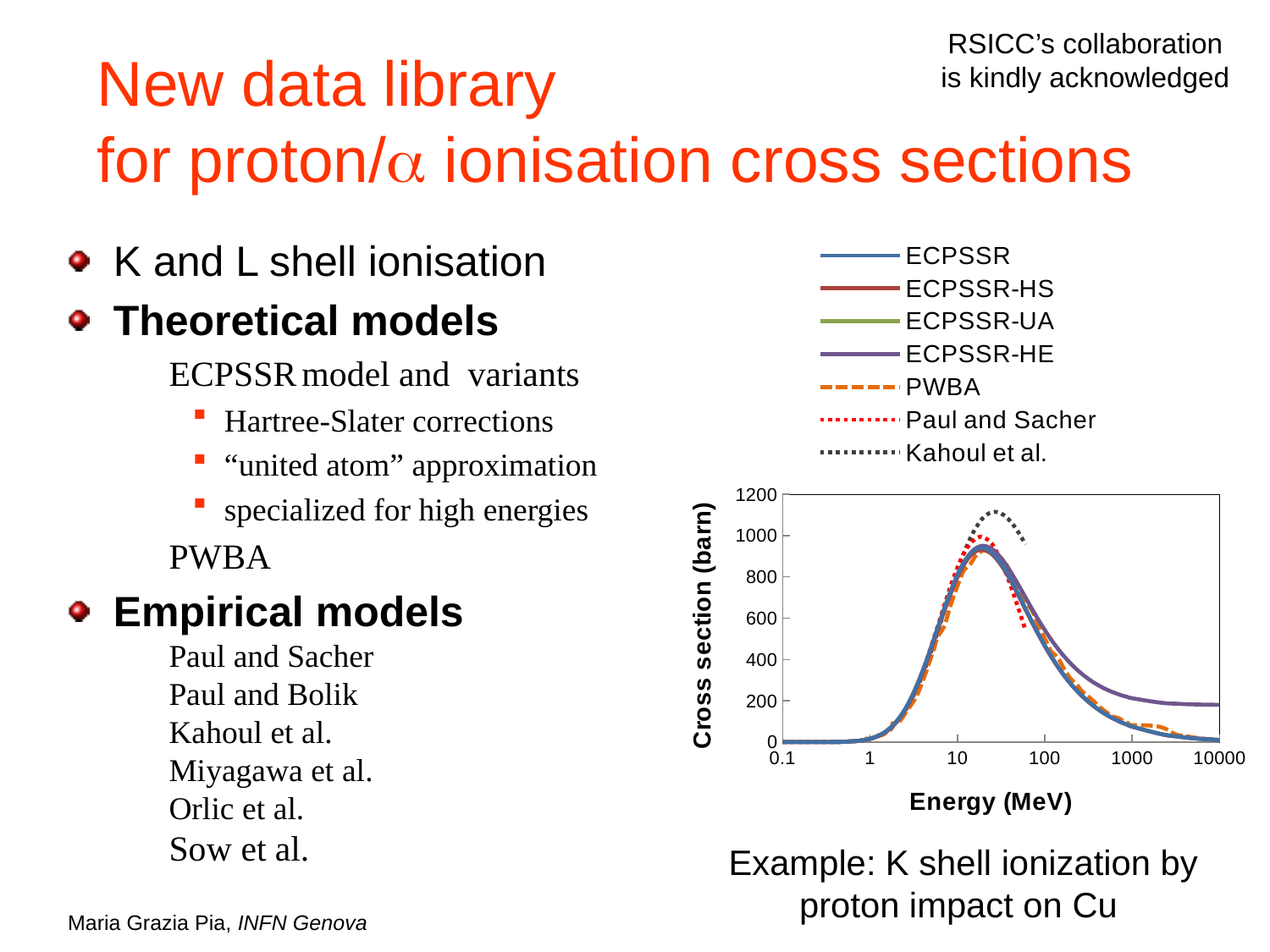
Is the peak value of the Kahoul et al. curve greater or less than 1000? greater Is the value of the ECPSSR curve at 1 MeV greater or less than 200? less Is the peak value of the ECPSSR curve greater or less than 800? greater Does the ECPSSR curve rise or fall between 1 MeV and 10 MeV? rise At 10000 MeV, which series has the higher cross section, ECPSSR-HE or ECPSSR? ECPSSR-HE How many series does the chart legend list? 7 What is the label of the y axis of the chart? Cross section (barn) What kind of chart is shown on the slide? line chart Does the ECPSSR curve rise or fall between 100 MeV and 10000 MeV? fall Which series reaches the highest peak cross section in the chart? Kahoul et al. What is the label of the x axis of the chart? Energy (MeV)